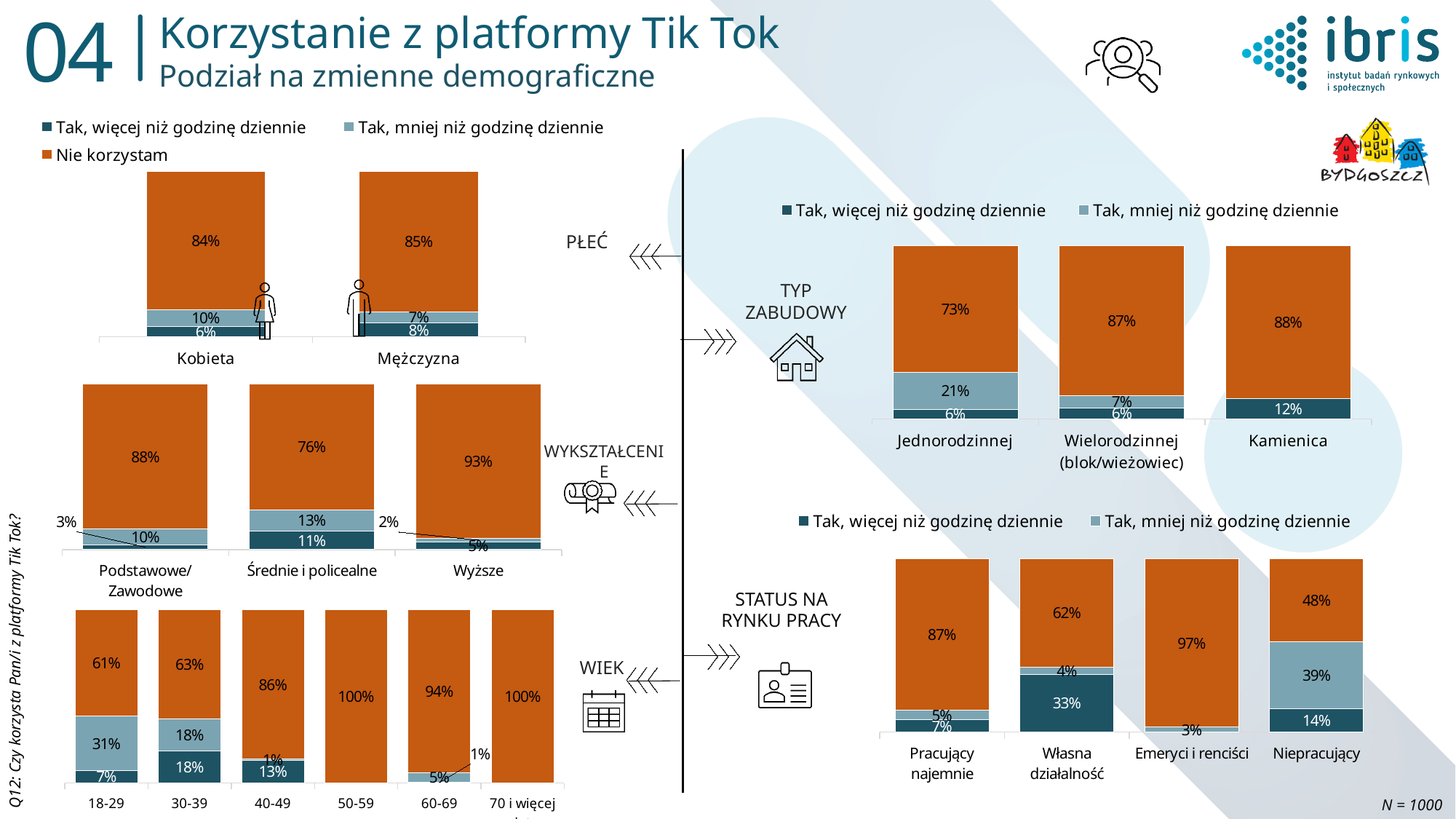
In the STATUS NA RYNKU PRACY chart, what is the 'Tak, więcej niż godzinę dziennie' value for Własna działalność? 33% In the WYKSZTAŁCENIE chart, what is the 'Tak, mniej niż godzinę dziennie' value for Średnie i policealne? 13% In the TYP ZABUDOWY chart, what is the 'Tak, więcej niż godzinę dziennie' value for Kamienica? 12% In the WIEK chart, what is the 'Tak, mniej niż godzinę dziennie' value for the 18-29 group? 31% How many series does the legend of the PŁEĆ chart list? 3 In the PŁEĆ chart, what percentage of Mężczyzna answered 'Tak, więcej niż godzinę dziennie'? 8% In the STATUS NA RYNKU PRACY chart, which group has the lowest 'Nie korzystam' share? Niepracujący In the PŁEĆ chart, what percentage of Kobieta answered 'Nie korzystam'? 84% In the WIEK chart, what is the difference between the 'Nie korzystam' values for 30-39 and 18-29? 2% In the TYP ZABUDOWY chart, which building type has the lowest 'Nie korzystam' share? Jednorodzinnej In the WYKSZTAŁCENIE chart, which education group has the highest 'Nie korzystam' share? Wyższe In the WIEK chart, how many age categories are shown? 6